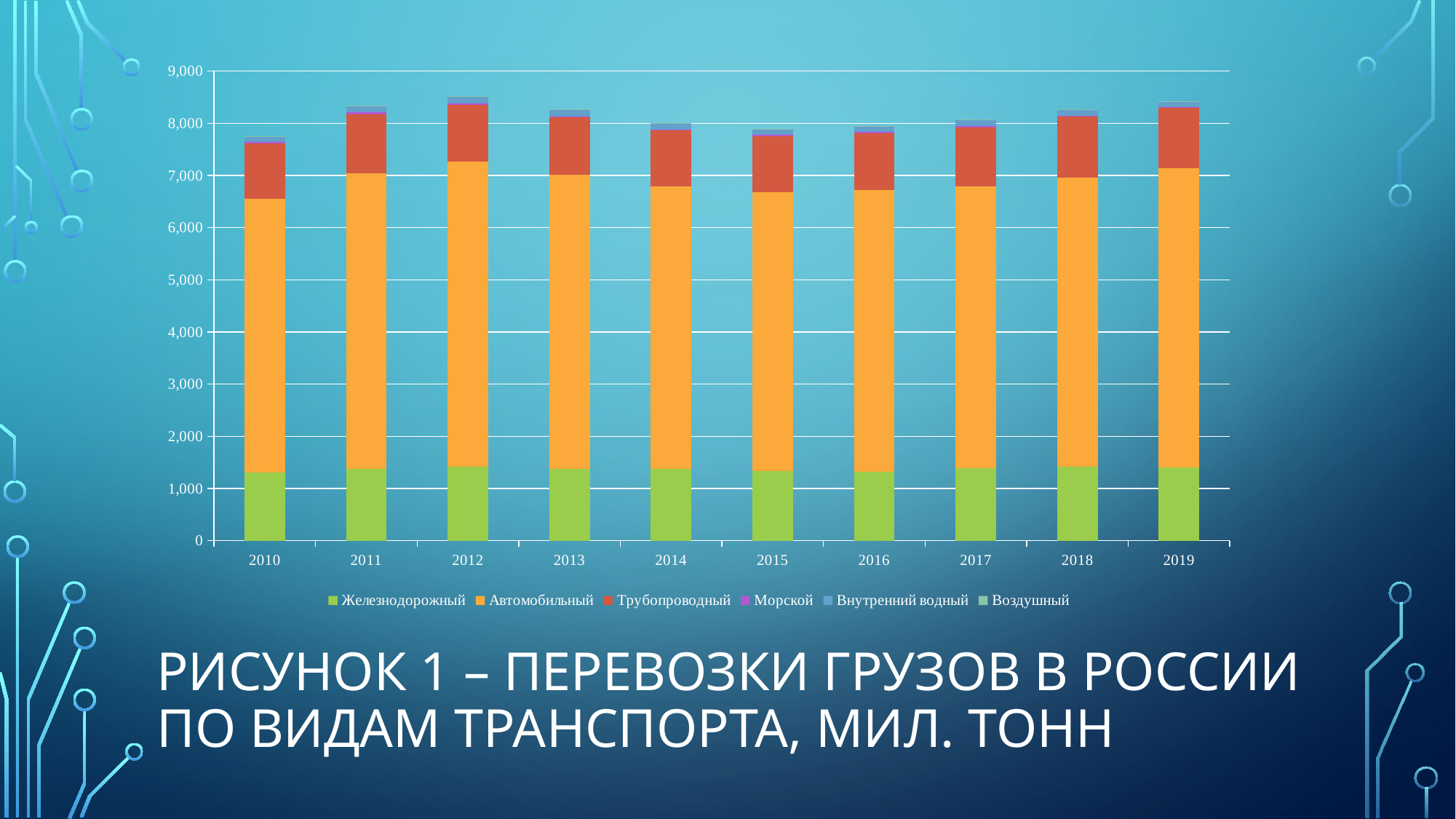
Which series is listed first in the chart legend? Железнодорожный How many series does the legend list? 6 Is the total height of the stacked bar for 2010 greater or less than 8,000? less Is the total height of the stacked bar for 2012 greater or less than 8,000? greater Is the total height of the stacked bar for 2015 greater or less than 8,000? less What kind of chart is shown on the slide? Stacked bar chart What colour represents the Автомобильный series in the chart? Orange How many years are shown on the x axis of the chart? 10